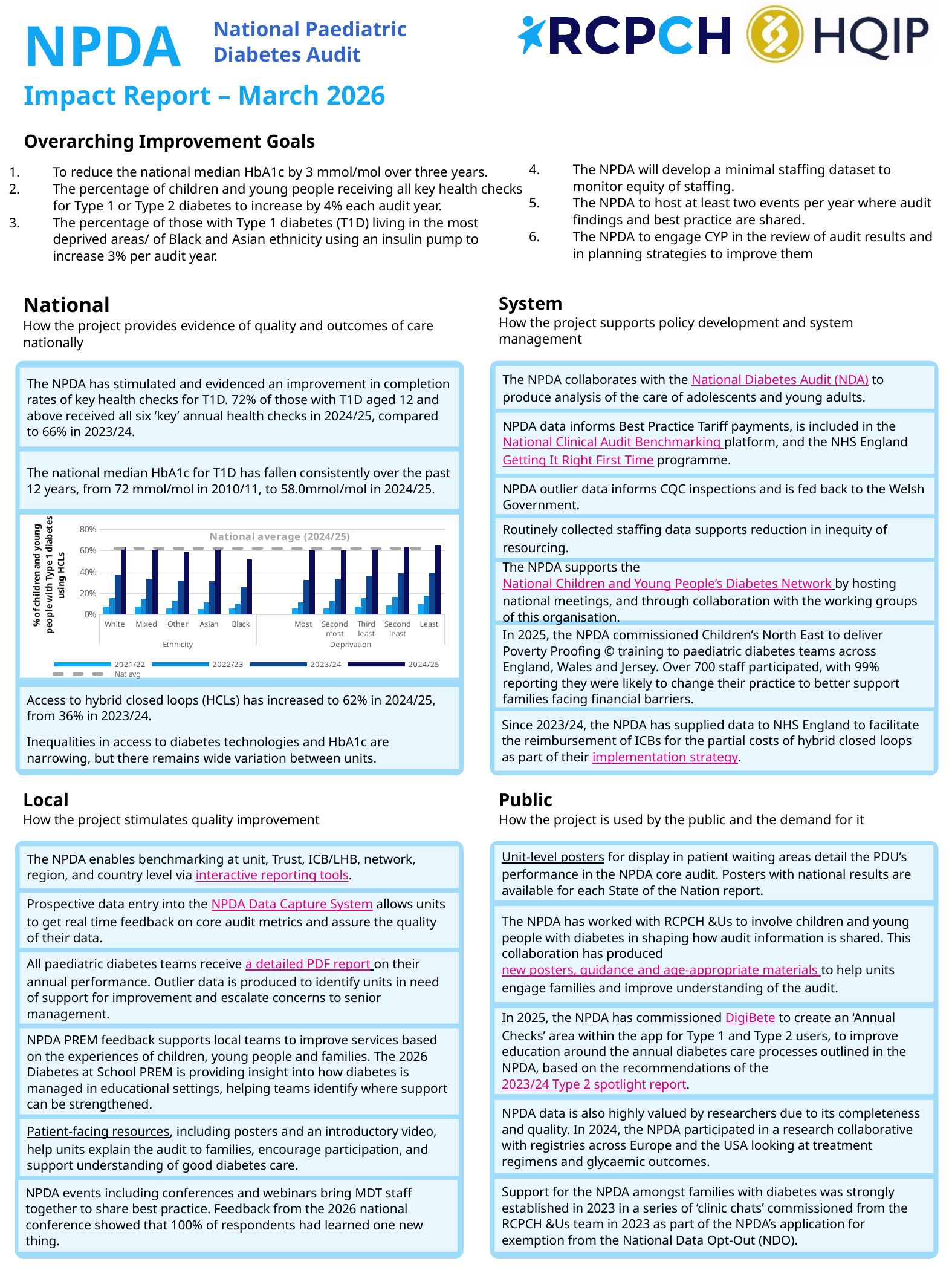
What kind of chart is shown on the slide? bar chart What does the dashed line in the chart represent, according to the legend? Nat avg Is the 2024/25 value for Black greater or less than 60%? less Which ethnicity group has the lowest 2024/25 value in the chart? Black Which deprivation group has the highest 2024/25 value in the chart? Least Do the values for White rise or fall from 2021/22 to 2024/25? rise Is the 2021/22 value for White greater or less than 20%? less Is the 2024/25 value for Least deprived greater or less than 60%? greater How many categories are shown along the x axis of the chart? 10 How many entries does the chart's legend list? 5 Which is larger in 2024/25: the value for Most deprived or for Least deprived? Least